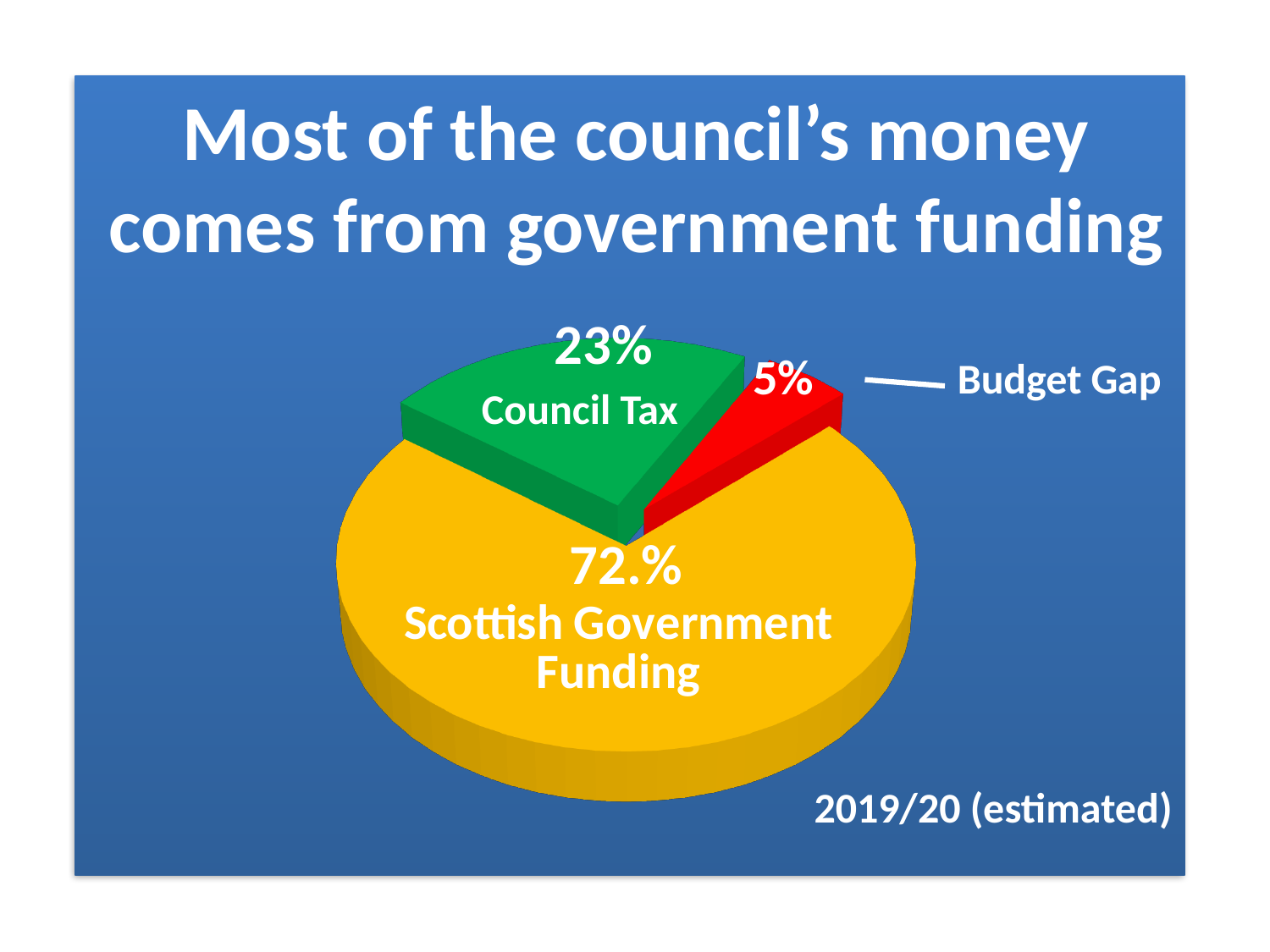
What value is printed on the Scottish Government Funding slice? 72.% What percentage of the pie is labelled Council Tax? 23% Which slice of the pie is the largest? Scottish Government Funding Which slice of the pie is the smallest? Budget Gap What percentage is shown for the Budget Gap slice? 5% What share of the pie does Council Tax represent? 23% What colour is the Budget Gap slice? Red Which year does the chart refer to, according to the note on the slide? 2019/20 (estimated) By how many percentage points is Council Tax larger than the Budget Gap? 18 percentage points How many slices does the pie chart have? 3 What kind of chart is shown on the slide? Pie chart Which is larger, Council Tax or Budget Gap? Council Tax